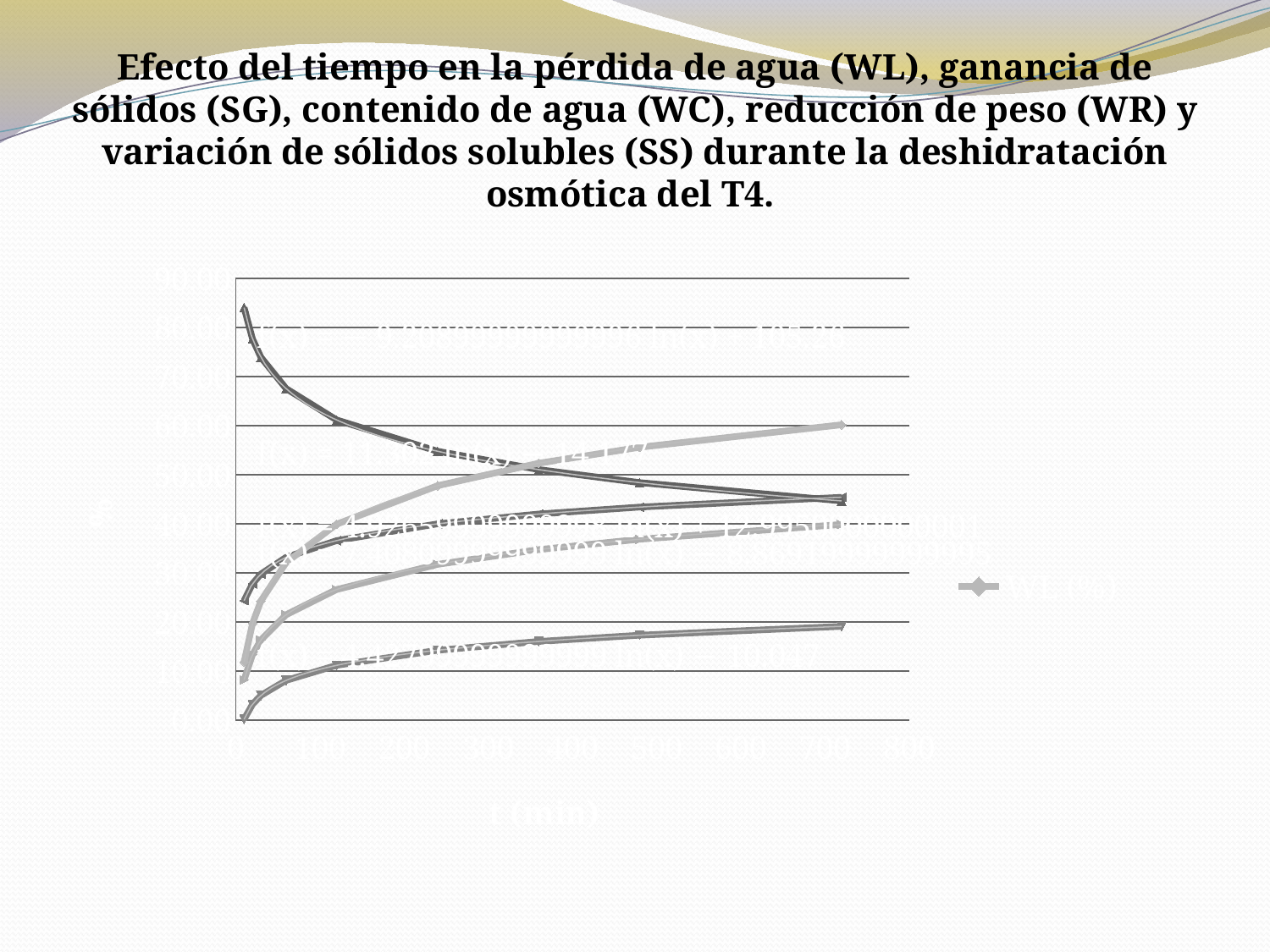
Which series name is shown in the chart legend? WL (%) Is the value of the light grey curve that ends highest at the right side greater or less than 50 at its right-hand end? greater Is the starting value of the topmost (descending) curve at t = 0 greater or less than 70? greater What is the title of the x axis of the chart? t (min) Is the value of the lowest curve at its right-hand end (around t = 700) greater or less than 30? less What kind of chart is shown on the slide? line chart Does the light grey curve that ends highest at the right side of the chart rise or fall as t (min) increases? rise Does the topmost curve, which starts near the top left of the chart, rise or fall as t (min) increases? fall